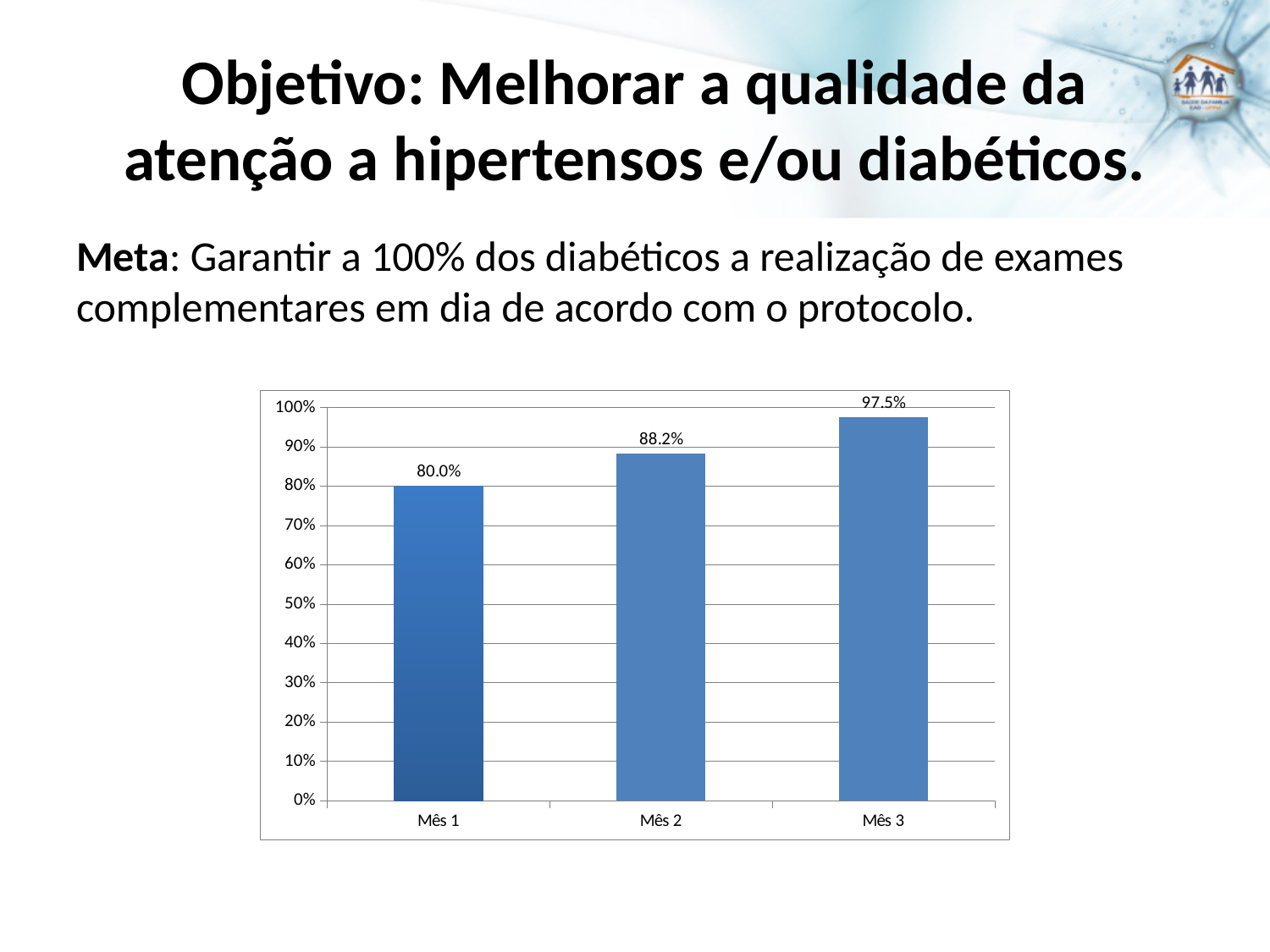
What is the value for Mês 3? 97.5% How many months are shown on the x axis? 3 Which month has the highest value? Mês 3 Which is larger, the value for Mês 2 or the value for Mês 3? Mês 3 Do the values rise or fall from Mês 1 to Mês 3? rise Is the value for Mês 2 greater or less than 90%? less What kind of chart is shown on the slide? bar chart What is the value for Mês 2? 88.2% What is the difference between the values for Mês 2 and Mês 1? 8.2% What is the difference between the values for Mês 3 and Mês 1? 17.5% Which month has the lowest value? Mês 1 What is the value for Mês 1? 80.0%